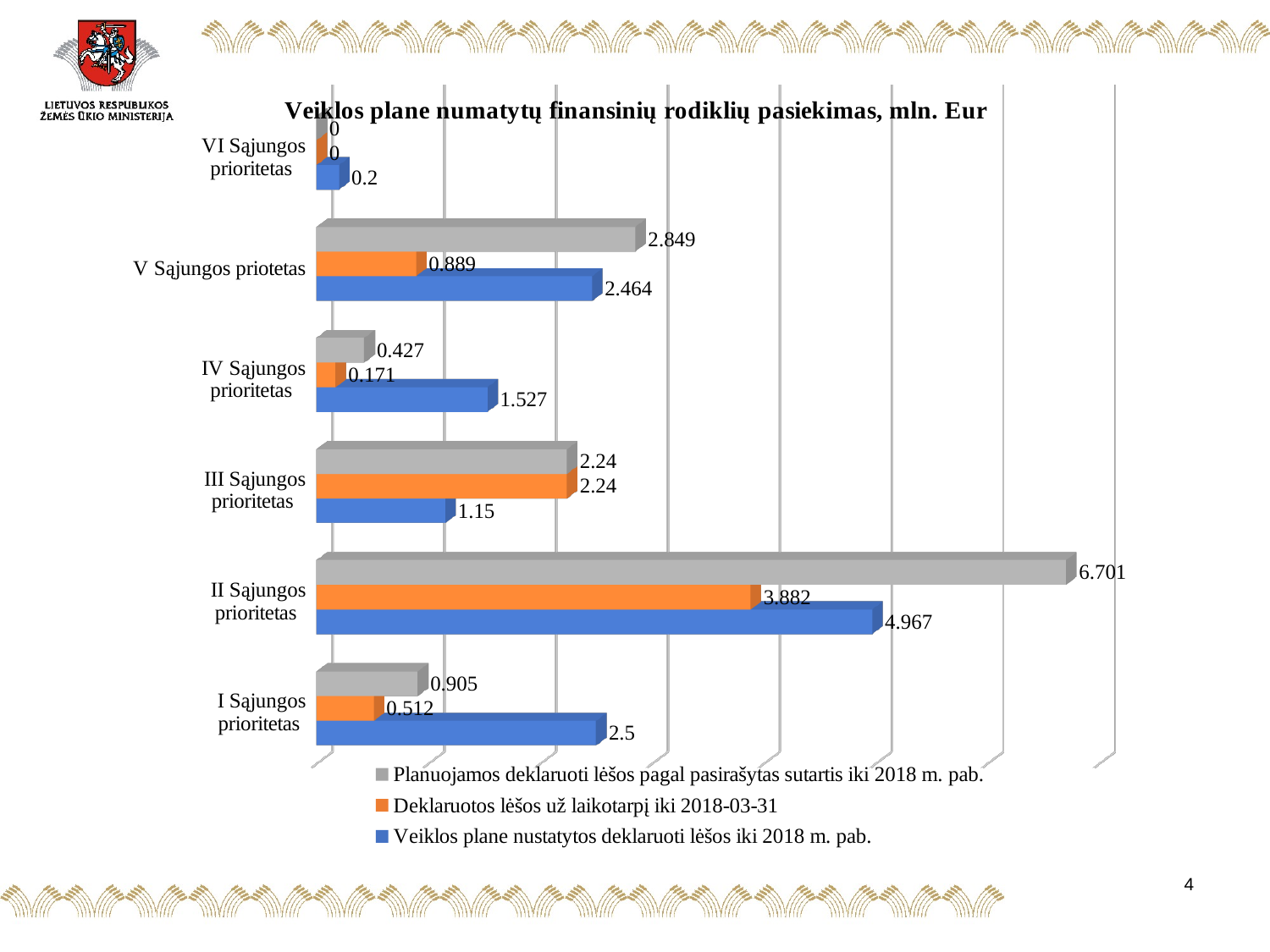
What is the difference between 'Veiklos plane nustatytos deklaruoti lėšos iki 2018 m. pab.' and 'Deklaruotos lėšos už laikotarpį iki 2018-03-31' for II Sąjungos prioritetas? 1.085 What is the title of the chart? Veiklos plane numatytų finansinių rodiklių pasiekimas, mln. Eur What is the value of 'Veiklos plane nustatytos deklaruoti lėšos iki 2018 m. pab.' for I Sąjungos prioritetas? 2.5 What type of chart is shown on the slide? bar chart Which priority has the highest value for 'Veiklos plane nustatytos deklaruoti lėšos iki 2018 m. pab.'? II Sąjungos prioritetas How many priority categories are shown on the chart? 6 For III Sąjungos prioritetas, which is larger: 'Deklaruotos lėšos už laikotarpį iki 2018-03-31' or 'Veiklos plane nustatytos deklaruoti lėšos iki 2018 m. pab.'? Deklaruotos lėšos už laikotarpį iki 2018-03-31 How many series does the legend list? 3 What is the difference between 'Planuojamos deklaruoti lėšos pagal pasirašytas sutartis iki 2018 m. pab.' and 'Deklaruotos lėšos už laikotarpį iki 2018-03-31' for IV Sąjungos prioritetas? 0.256 Which priority has the lowest value for 'Planuojamos deklaruoti lėšos pagal pasirašytas sutartis iki 2018 m. pab.'? VI Sąjungos prioritetas What is the value of 'Deklaruotos lėšos už laikotarpį iki 2018-03-31' for V Sąjungos priotetas? 0.889 What is the value of 'Planuojamos deklaruoti lėšos pagal pasirašytas sutartis iki 2018 m. pab.' for II Sąjungos prioritetas? 6.701